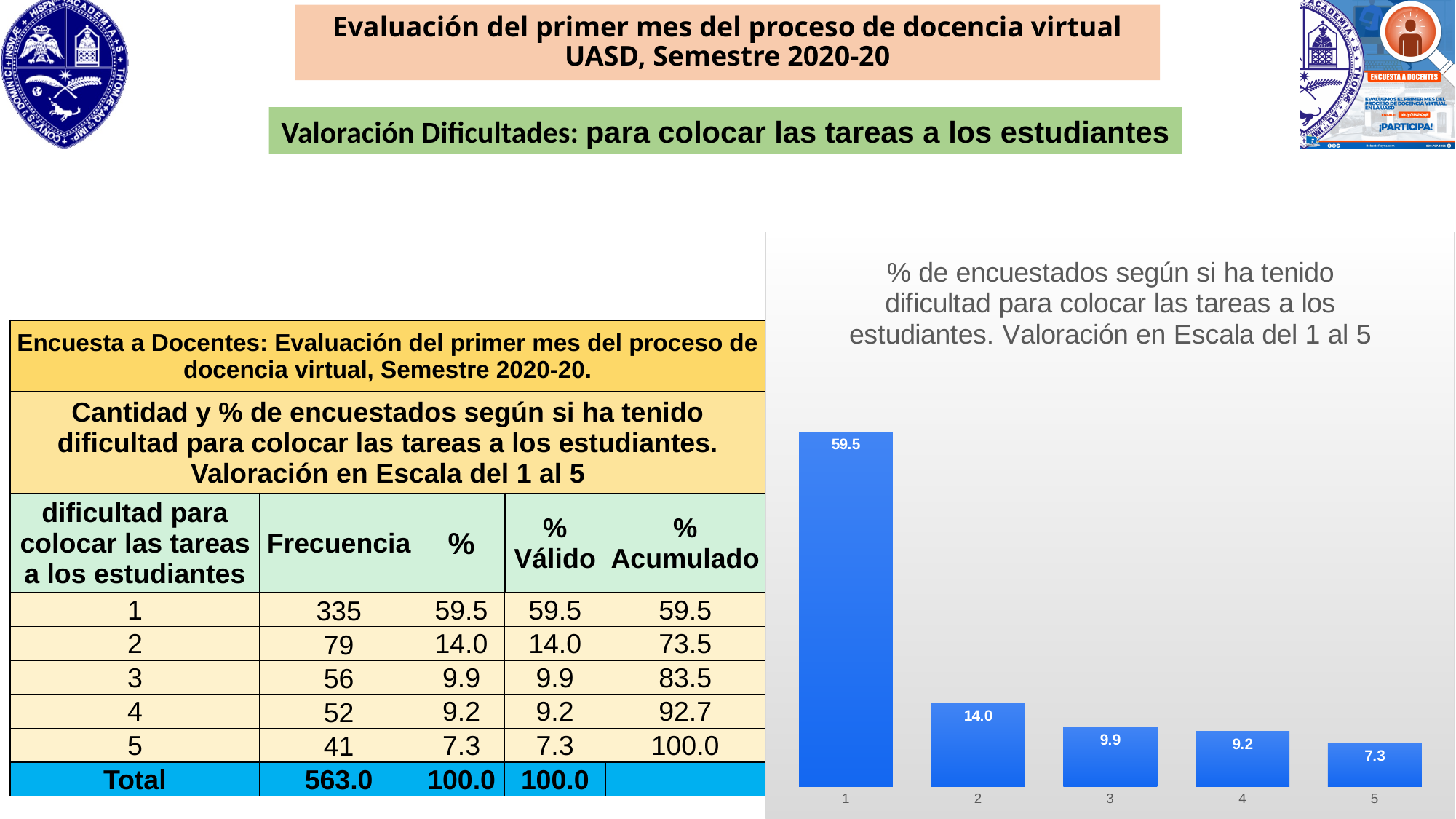
What is the value for category 5 in the chart? 7.3 What colour are the bars in the chart? blue Which category has the highest value in the chart? 1 Which is larger, the value for category 2 or the value for category 3? 2 Which category has the lowest value in the chart? 5 What is the difference between the values for category 1 and category 2? 45.5 Do the values rise or fall from category 1 to category 5? fall What is the value for category 1 in the chart? 59.5 What is the value for category 2 in the chart? 14.0 How many categories are shown in the chart? 5 What kind of chart is shown on the slide? bar chart What is the difference between the values for category 3 and category 4? 0.7